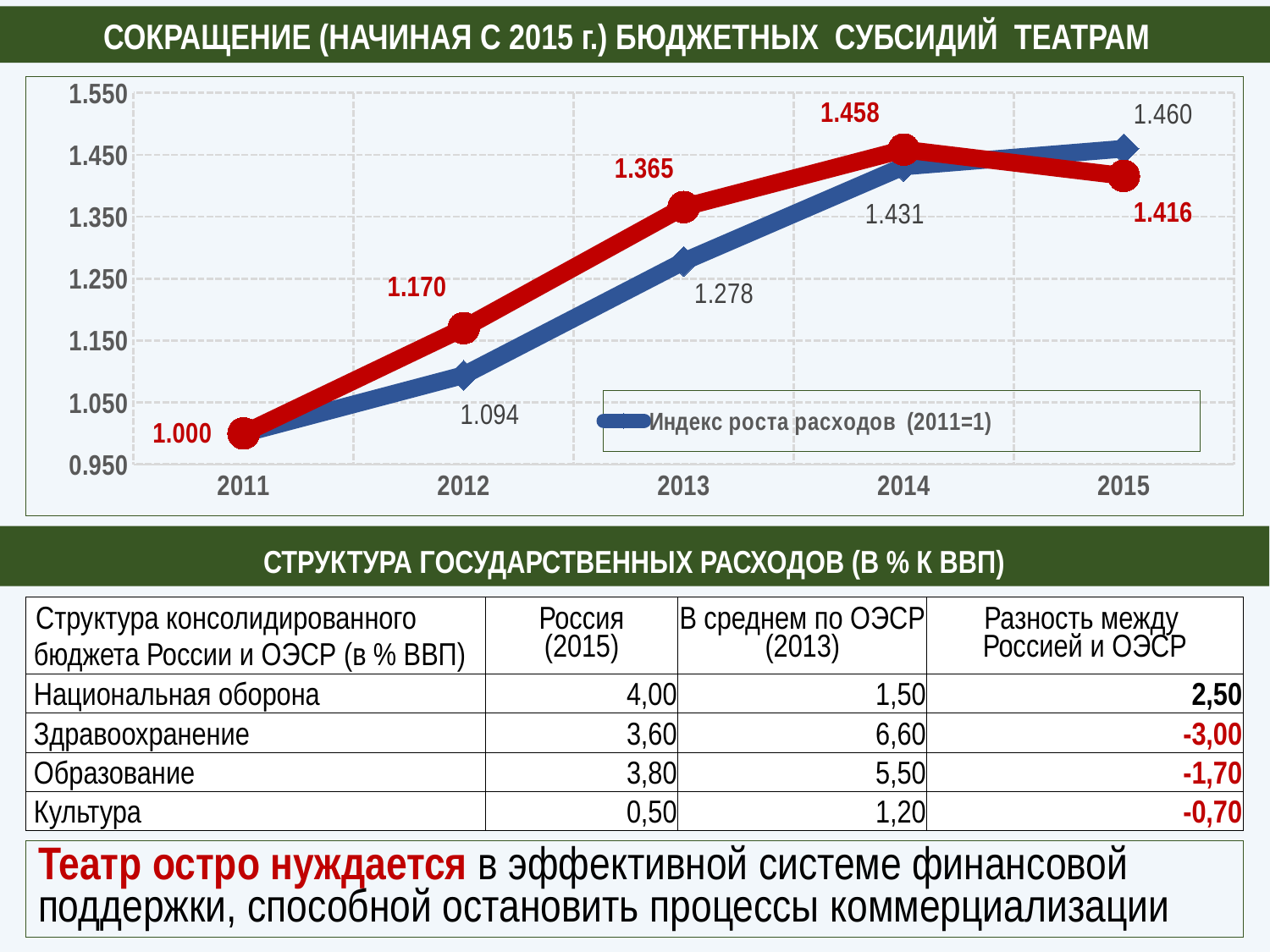
What legend entry is shown for the blue line in the chart? Индекс роста расходов (2011=1) What is the value of the red line in 2014? 1.458 By how much does the red line fall from 2014 to 2015? 0.042 In 2013, which line has the higher value, the red line or the blue line? the red line How many years are plotted along the x axis of the line chart? 5 Does the blue line (Индекс роста расходов (2011=1)) rise or fall from 2011 to 2015? rise In which year does the blue line (Индекс роста расходов (2011=1)) reach its highest value? 2015 What kind of chart is shown at the top of the slide? line chart What is the value of the blue line (Индекс роста расходов (2011=1)) in 2013? 1.278 What is the value of the red line in 2012? 1.170 In which year does the red line reach its highest value? 2014 What is the value of the blue line (Индекс роста расходов (2011=1)) in 2015? 1.460